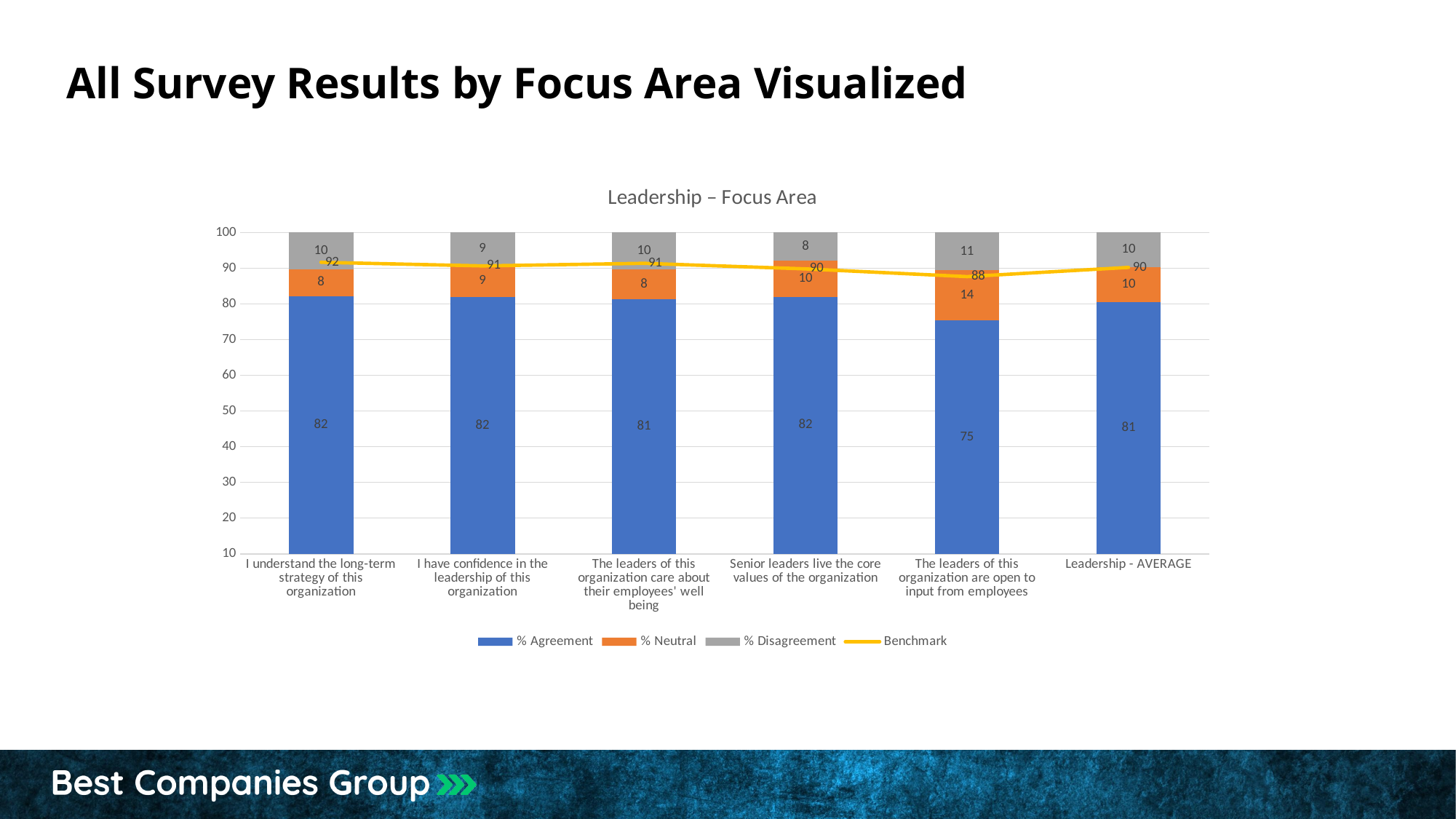
What is the difference between the Benchmark value for "I understand the long-term strategy of this organization" and the Benchmark value for "The leaders of this organization are open to input from employees"? 4 How many series does the legend list? 4 What is the % Agreement value for "The leaders of this organization are open to input from employees"? 75 What is the title of the chart? Leadership – Focus Area Which is larger: the % Agreement value for "Senior leaders live the core values of the organization" or the % Agreement value for "The leaders of this organization are open to input from employees"? Senior leaders live the core values of the organization What is the % Disagreement value for "Leadership - AVERAGE"? 10 How many categories are shown on the x axis? 6 Which category has the highest % Neutral value? The leaders of this organization are open to input from employees Is the % Agreement value for "I have confidence in the leadership of this organization" greater or less than 70? greater What is the Benchmark value for "I understand the long-term strategy of this organization"? 92 Which category has the lowest % Agreement value? The leaders of this organization are open to input from employees What is the % Neutral value for "Senior leaders live the core values of the organization"? 10